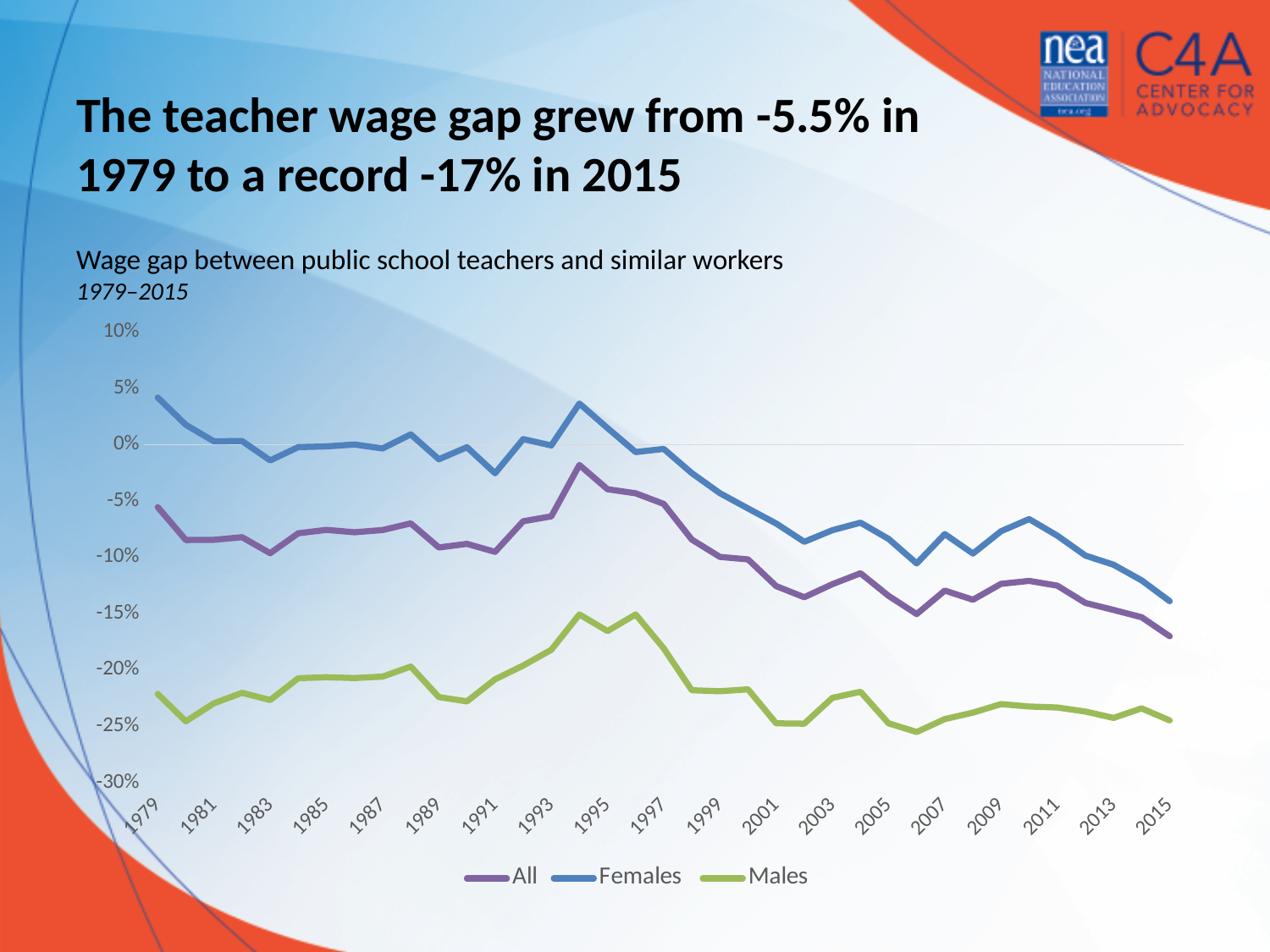
Which series has the lowest values across the whole period? Males Does the All series generally rise or fall from 1979 to 2015? fall What is the subtitle of the chart? Wage gap between public school teachers and similar workers How many series does the legend list? 3 According to the slide, what was the teacher wage gap in 2015? -17% According to the slide, what was the teacher wage gap in 1979? -5.5% What kind of chart is shown on the slide? line chart Is the value for Males in 1979 greater or less than -20%? less In 2015, which is larger, the value for Females or the value for Males? Females Which series has the highest values across the whole period? Females What are the three series named in the legend? All, Females, Males Is the value for Females in 1979 greater or less than 0%? greater